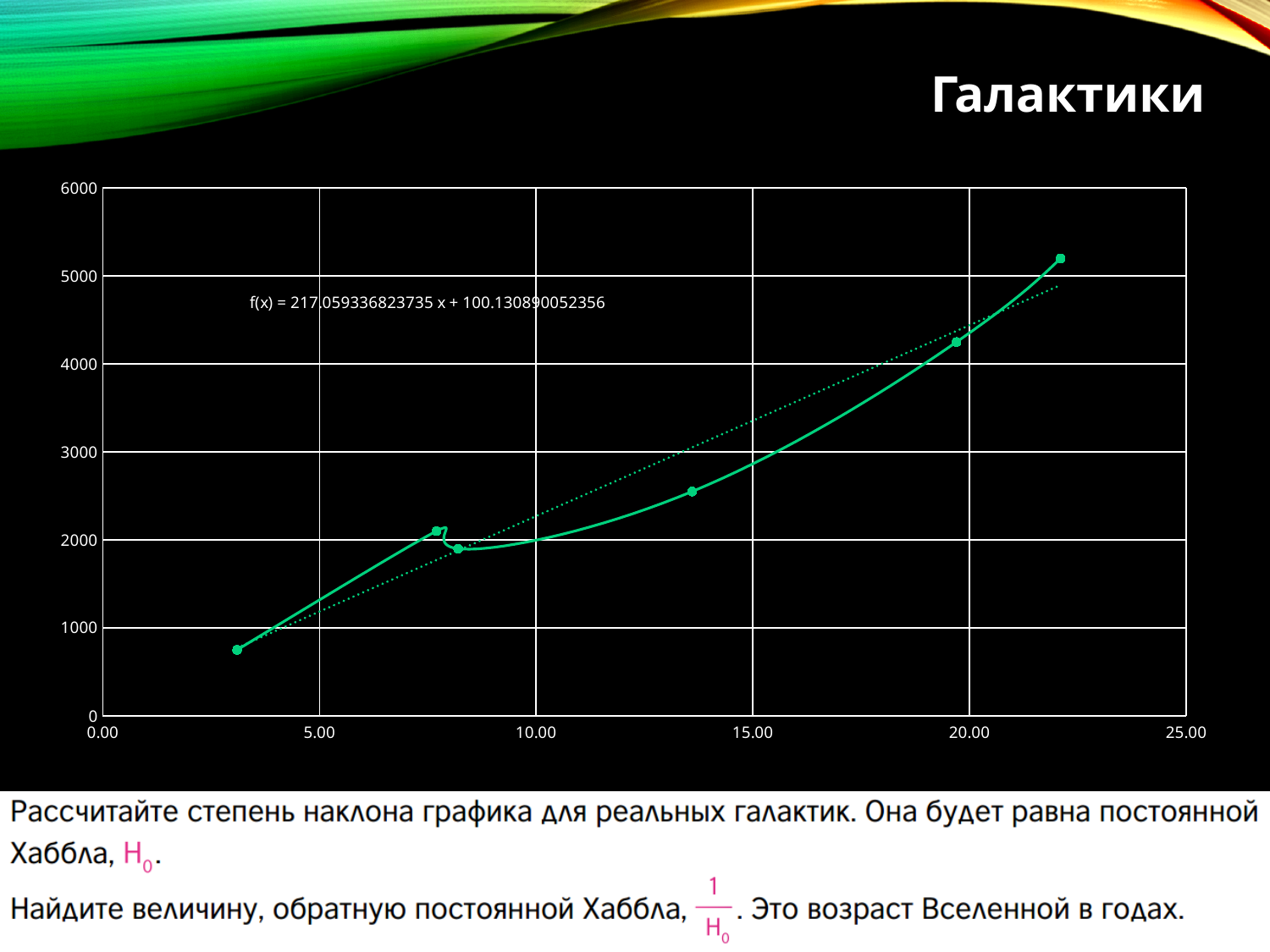
Is the value of the data point near x = 13.6 greater or less than 3000? less Is the value of the data point near x = 19.7 greater or less than 4000? greater What is the maximum value shown on the y axis? 6000 Do the plotted values generally rise or fall as x increases along the x axis? rise What kind of chart is shown on the slide? line chart Is the value of the leftmost data point (near x = 3) greater or less than 1000? less What is the trendline equation printed on the chart? f(x) = 217.059336823735 x + 100.130890052356 Which data point has the highest value: the one near x = 22 or the one near x = 3? the one near x = 22 What is the slope of the trendline shown in the equation on the chart? 217.059336823735 What is the maximum value shown on the x axis? 25.00 How many data points are plotted on the chart? 6